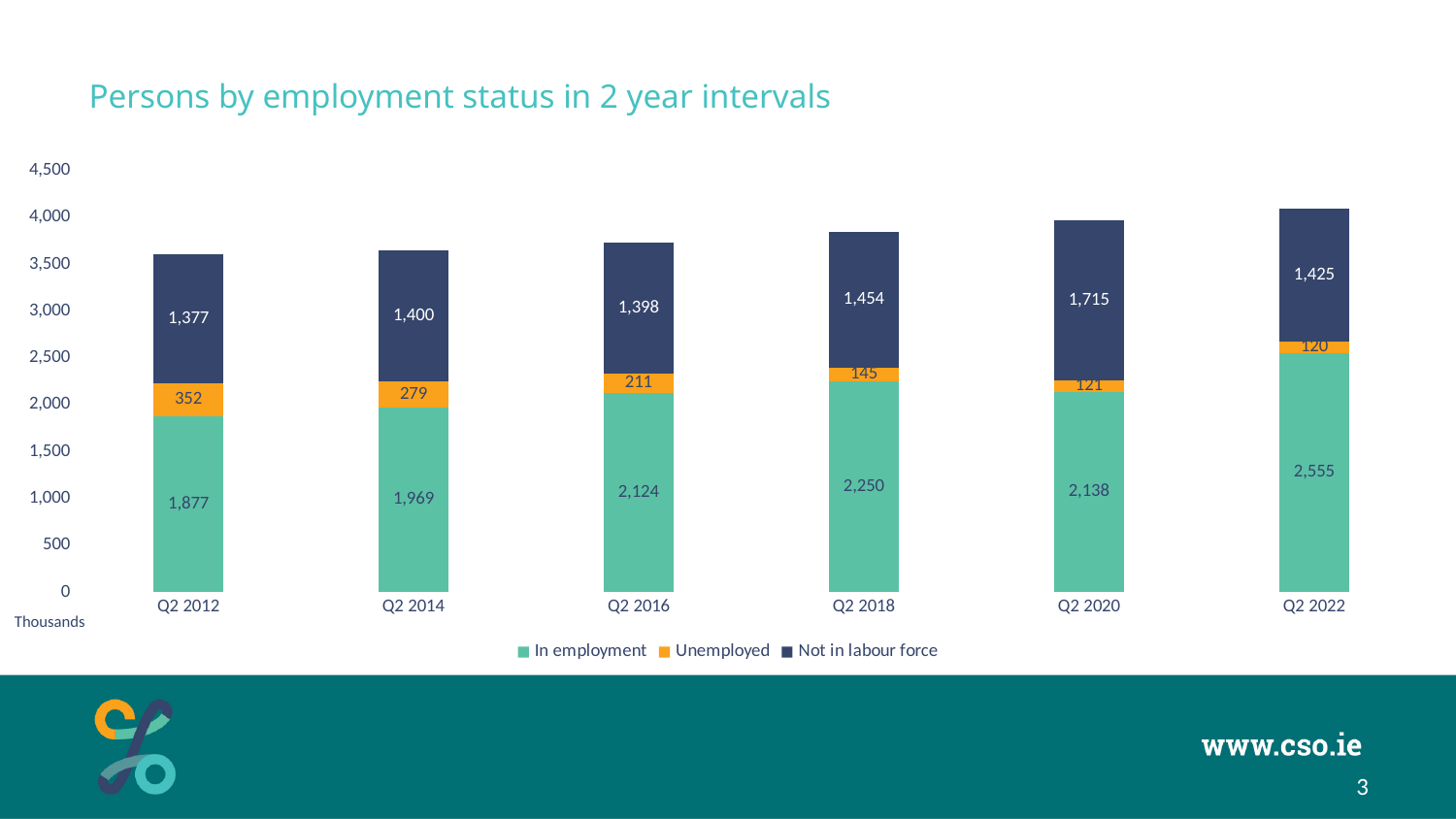
What is the value for In employment in Q2 2018? 2,250 What type of chart is shown on the slide? Stacked bar chart What is the title of the chart? Persons by employment status in 2 year intervals What is the value for Not in labour force in Q2 2020? 1,715 In which period is the Unemployed value highest? Q2 2012 Which is larger, the Not in labour force value in Q2 2018 or in Q2 2022? Q2 2018 What is the value for Unemployed in Q2 2012? 352 How many time periods are shown on the x axis? 6 What is the total of the stacked bar for Q2 2012? 3,606 What is the difference between the In employment values in Q2 2022 and Q2 2020? 417 In which period is the In employment value highest? Q2 2022 How many series does the legend list? 3